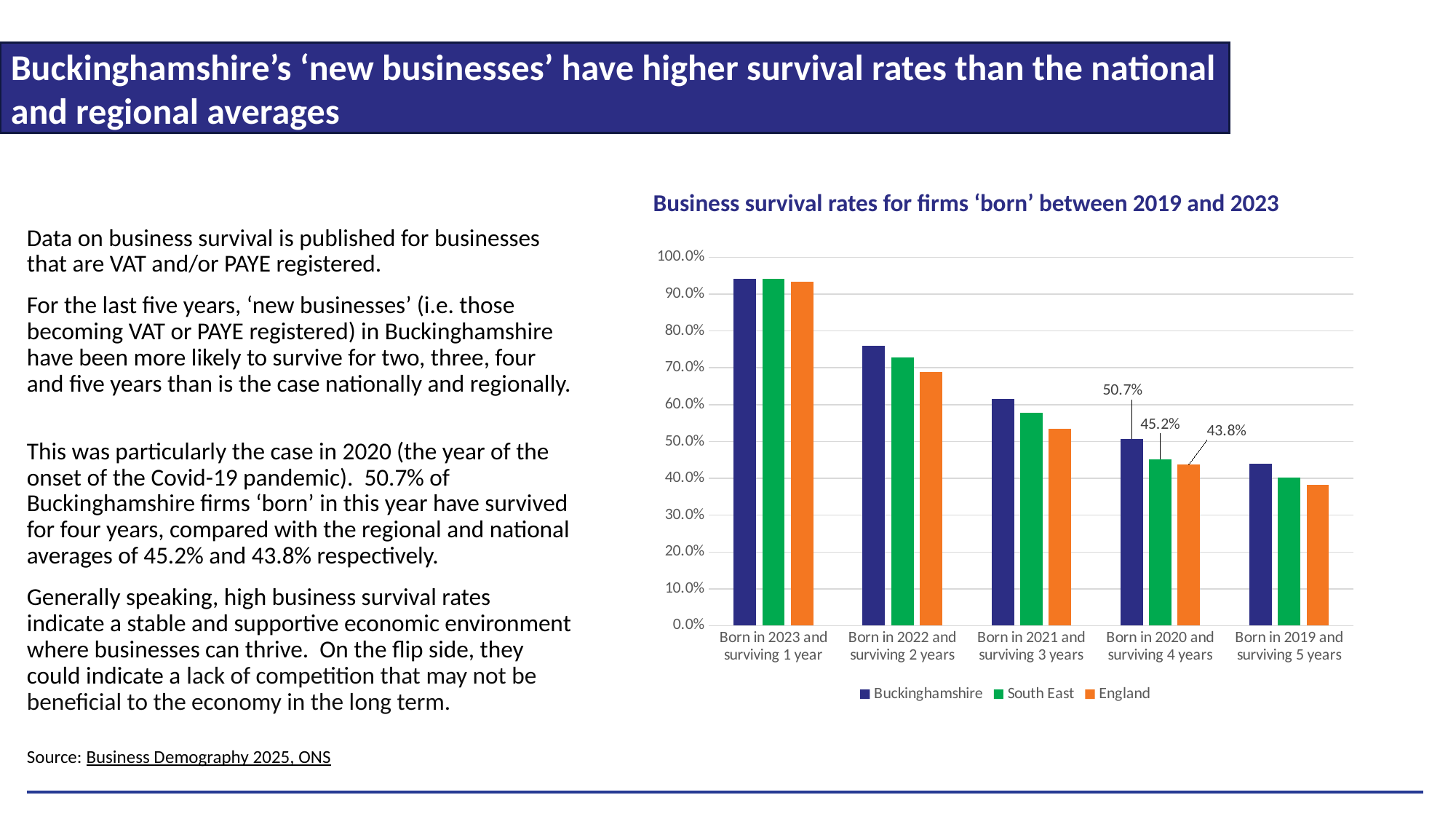
Which category has the lowest England value? Born in 2019 and surviving 5 years Which category has the highest Buckinghamshire value? Born in 2023 and surviving 1 year Is the value for Buckinghamshire in 'Born in 2023 and surviving 1 year' greater or less than 90.0%? greater In the 'Born in 2020 and surviving 4 years' category, how many percentage points higher is Buckinghamshire than England? 6.9 percentage points What is the value for England in the 'Born in 2020 and surviving 4 years' category? 43.8% What kind of chart is shown? Bar chart In the 'Born in 2022 and surviving 2 years' category, which is larger: Buckinghamshire or England? Buckinghamshire What is the value for South East in the 'Born in 2020 and surviving 4 years' category? 45.2% How many series does the legend list? 3 How many categories are shown on the x axis? 5 Do the Buckinghamshire values rise or fall moving from left to right along the x axis? Fall What is the value for Buckinghamshire in the 'Born in 2020 and surviving 4 years' category? 50.7%